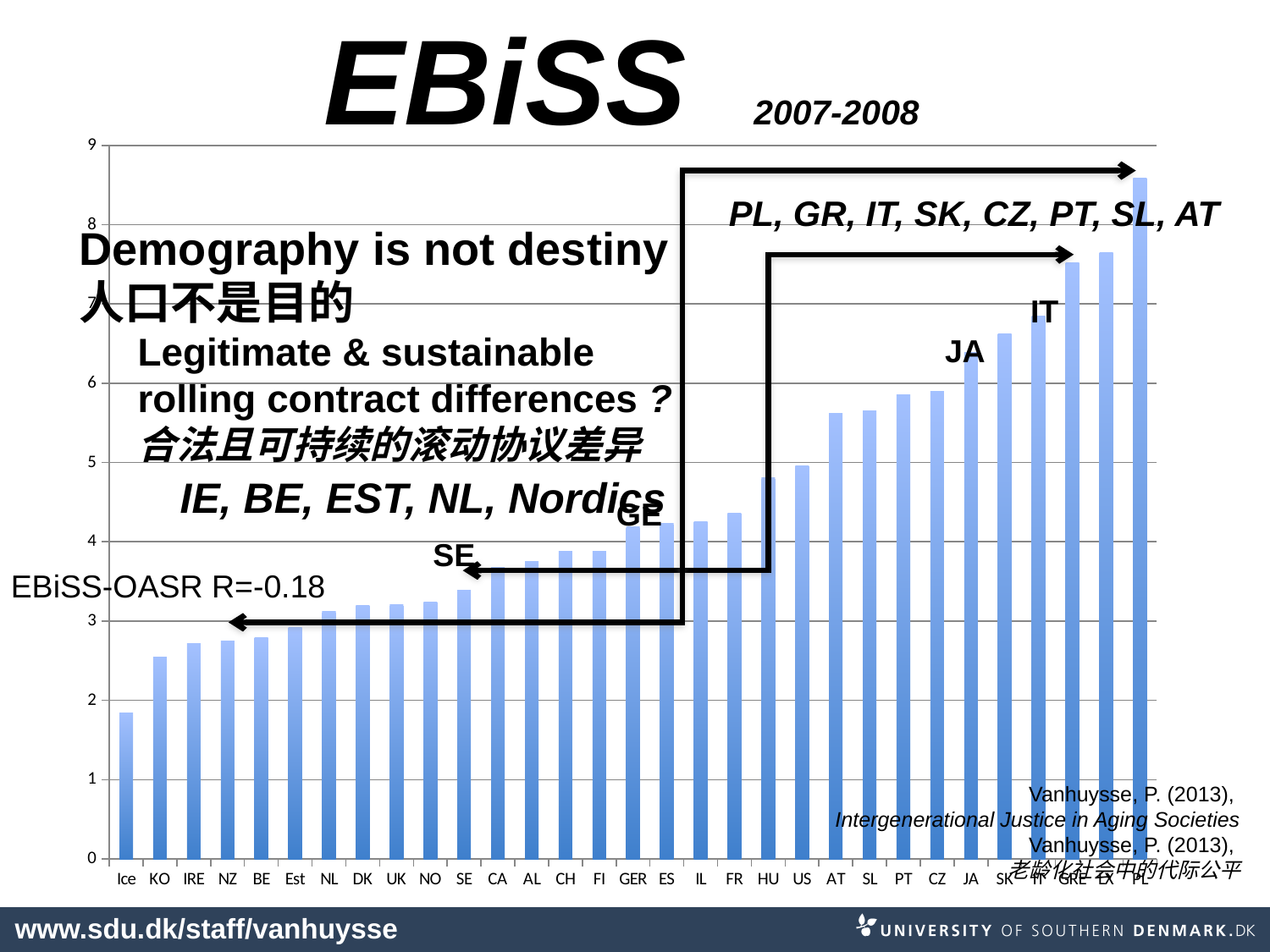
Do the bar values rise or fall from left to right along the x axis? rise Which has the larger value, JA or SE? JA Is the value for HU greater or less than 5? less Is the value for CA greater or less than 4? less Which country has the highest EBiSS value? PL Is the value for PL greater or less than 8? greater What kind of chart is shown on the slide? bar chart Which country has the lowest EBiSS value? Ice What period is shown next to the chart title? 2007-2008